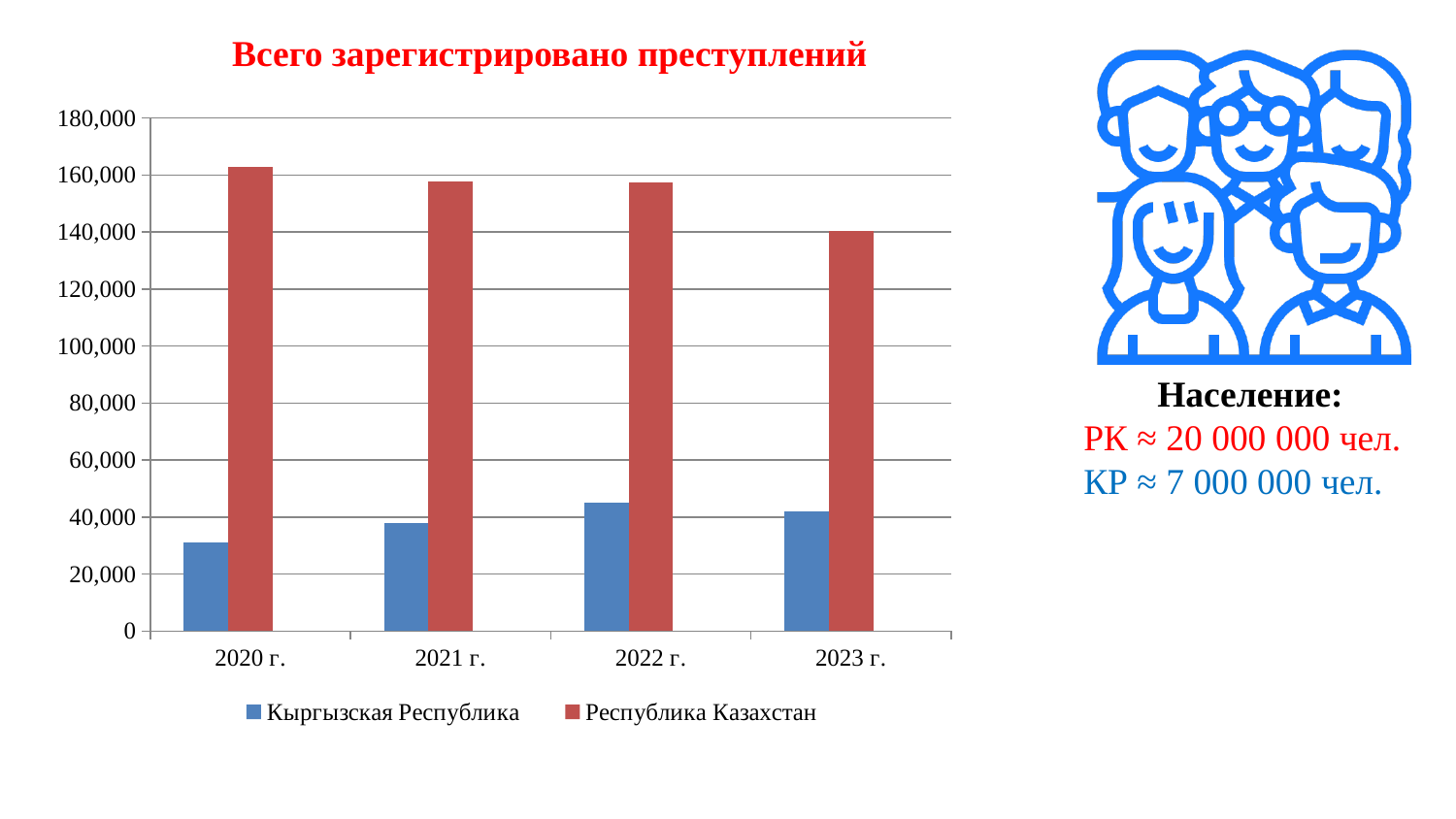
How many series does the legend list? 2 What is the title of the chart? Всего зарегистрировано преступлений Do the values for Республика Казахстан rise or fall from 2020 г. to 2023 г.? fall Is the value for Республика Казахстан in 2023 г. greater or less than 160,000? less What kind of chart is shown on the slide? bar chart Which year has the lowest value for Республика Казахстан? 2023 г. Is the value for Кыргызская Республика in 2020 г. greater or less than 40,000? less Which year has the highest value for Республика Казахстан? 2020 г. Which is larger in 2021 г.: the value for Кыргызская Республика or for Республика Казахстан? Республика Казахстан Is the value for Кыргызская Республика in 2022 г. greater or less than 40,000? greater Which year has the lowest value for Кыргызская Республика? 2020 г. How many years are shown on the x axis of the chart? 4